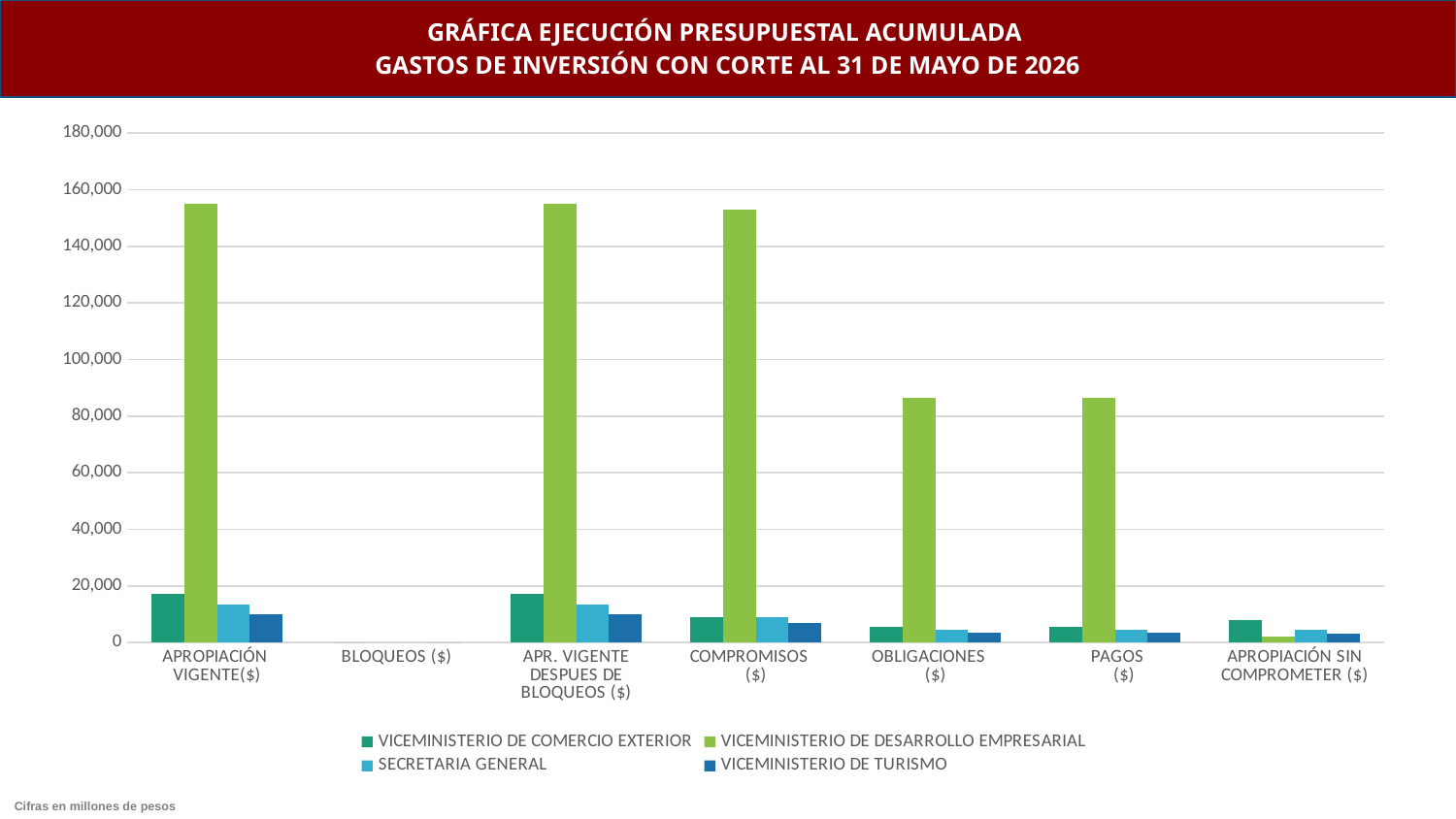
How many series does the legend list? 4 Is the value for VICEMINISTERIO DE COMERCIO EXTERIOR in APROPIACIÓN VIGENTE($) greater or less than 20,000? less Is the value for VICEMINISTERIO DE DESARROLLO EMPRESARIAL in APROPIACIÓN VIGENTE($) greater or less than 140,000? greater Which series has the lowest value in the APROPIACIÓN VIGENTE($) category? VICEMINISTERIO DE TURISMO For VICEMINISTERIO DE DESARROLLO EMPRESARIAL, which is larger: COMPROMISOS ($) or OBLIGACIONES ($)? COMPROMISOS ($) Is the value for VICEMINISTERIO DE DESARROLLO EMPRESARIAL in APROPIACIÓN SIN COMPROMETER ($) greater or less than 20,000? less How many categories are shown on the x axis? 7 What kind of chart is shown on the slide? bar chart According to the note at the bottom of the slide, in what units are the figures expressed? millones de pesos Which category on the x axis shows no bars at all? BLOQUEOS ($) Which series has the highest value in the APROPIACIÓN VIGENTE($) category? VICEMINISTERIO DE DESARROLLO EMPRESARIAL